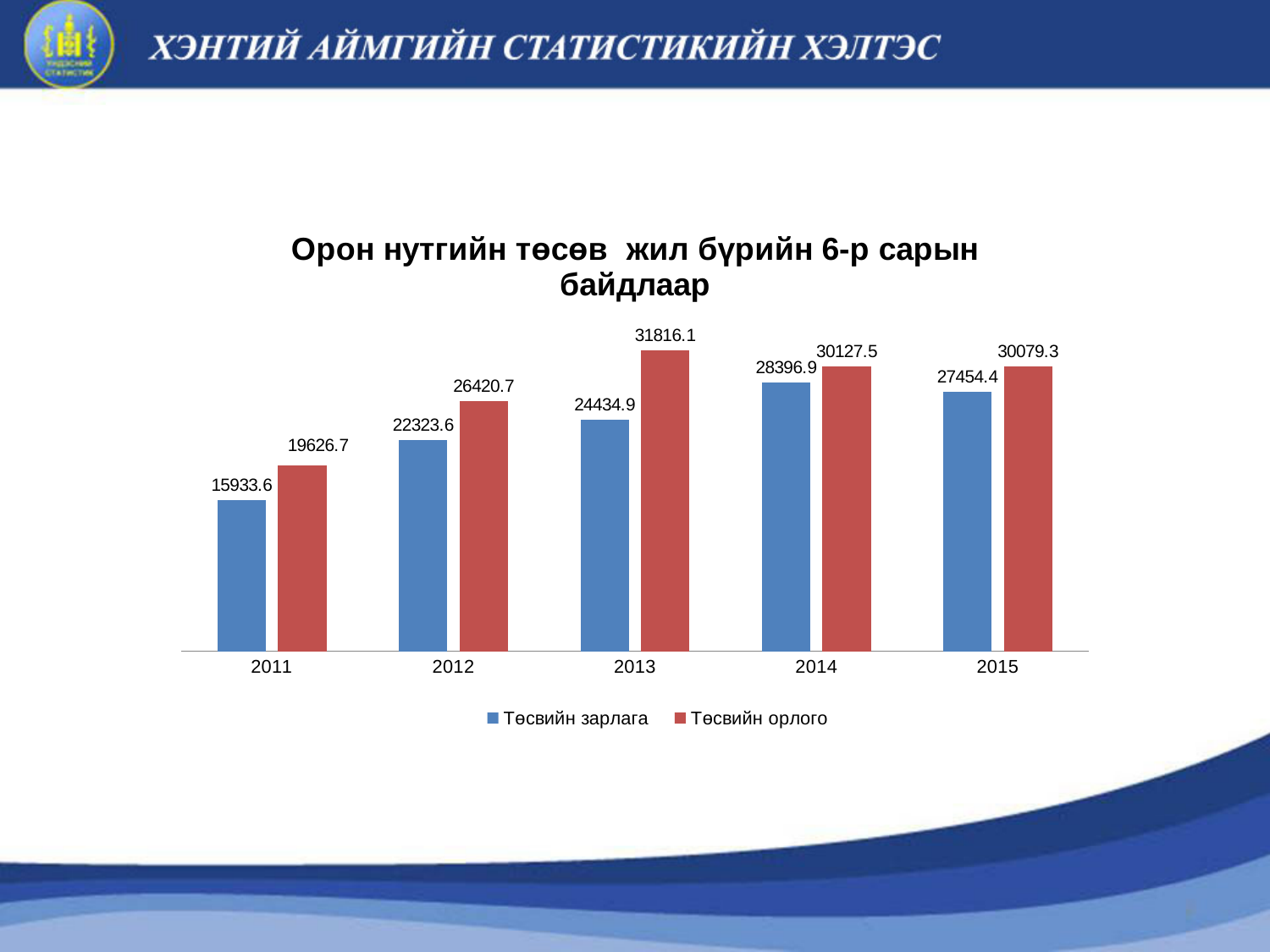
How many series does the legend list? 2 What is the value of Төсвийн зарлага for 2014? 28396.9 How many years are shown on the x axis? 5 What is the value of Төсвийн зарлага for 2011? 15933.6 In which year is Төсвийн орлого highest? 2013 In which year is Төсвийн зарлага lowest? 2011 What is the difference between Төсвийн орлого and Төсвийн зарлага in 2013? 7381.2 What is the value of Төсвийн орлого for 2015? 30079.3 What is the value of Төсвийн орлого for 2013? 31816.1 What is the difference between Төсвийн орлого and Төсвийн зарлага in 2011? 3693.1 Which is larger in 2012, Төсвийн зарлага or Төсвийн орлого? Төсвийн орлого What kind of chart is shown on the slide? Bar chart